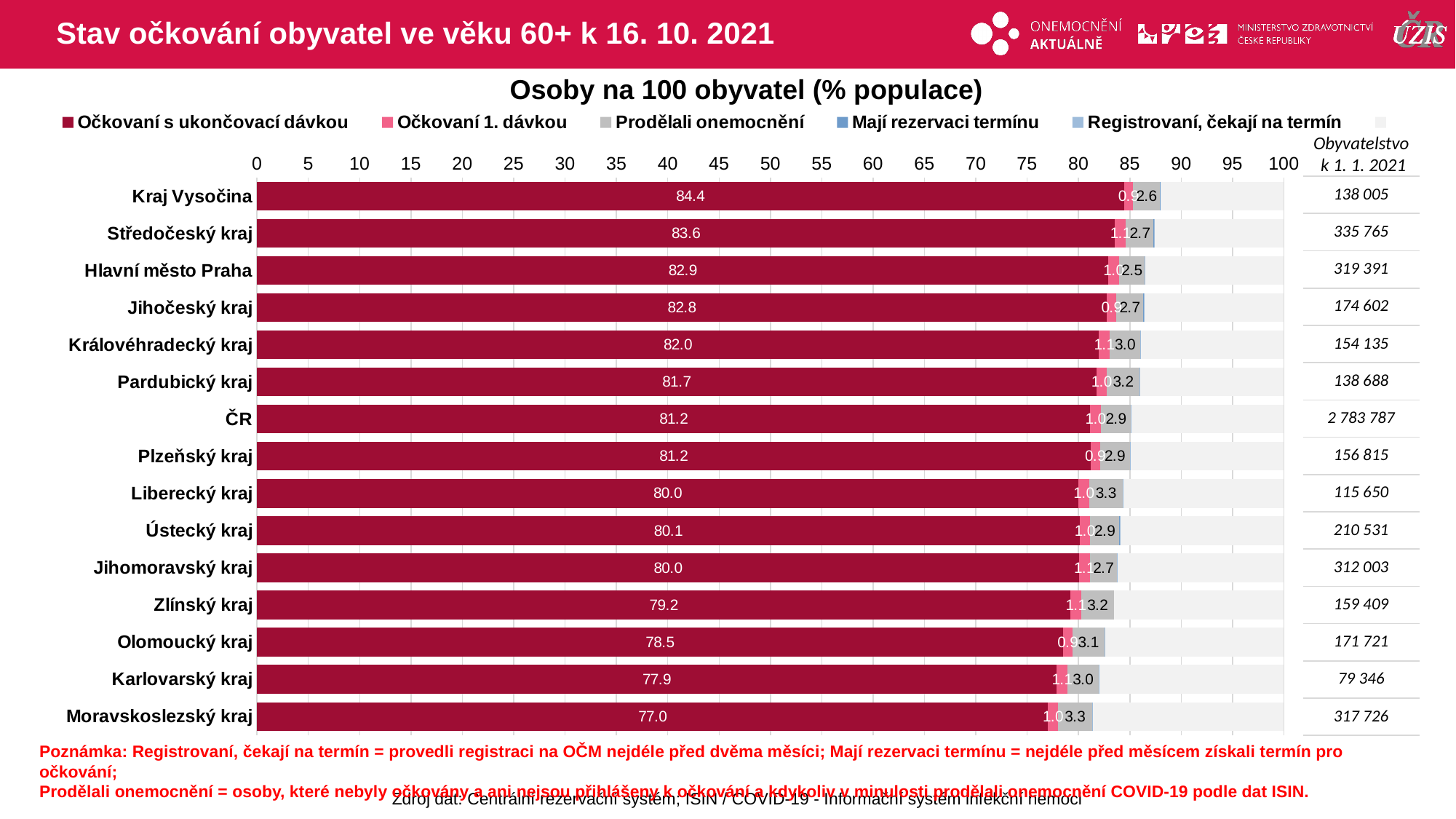
What is the value of "Prodělali onemocnění" for Pardubický kraj? 3.2 Is the value of "Očkovaní s ukončovací dávkou" for Olomoucký kraj greater or less than 80? less Which has a larger value of "Očkovaní s ukončovací dávkou": Jihočeský kraj or Zlínský kraj? Jihočeský kraj Which category has the lowest value of "Očkovaní s ukončovací dávkou"? Moravskoslezský kraj How many categories (rows) are shown on the chart? 15 What is the value of "Očkovaní s ukončovací dávkou" for Moravskoslezský kraj? 77.0 What is the value of "Očkovaní s ukončovací dávkou" for Kraj Vysočina? 84.4 Which category has the highest value of "Očkovaní s ukončovací dávkou"? Kraj Vysočina What is the difference in "Očkovaní s ukončovací dávkou" between Kraj Vysočina and Moravskoslezský kraj? 7.4 What is the title of the chart? Osoby na 100 obyvatel (% populace) What is the value of "Očkovaní s ukončovací dávkou" for ČR? 81.2 What kind of chart is shown on the slide? Stacked horizontal bar chart